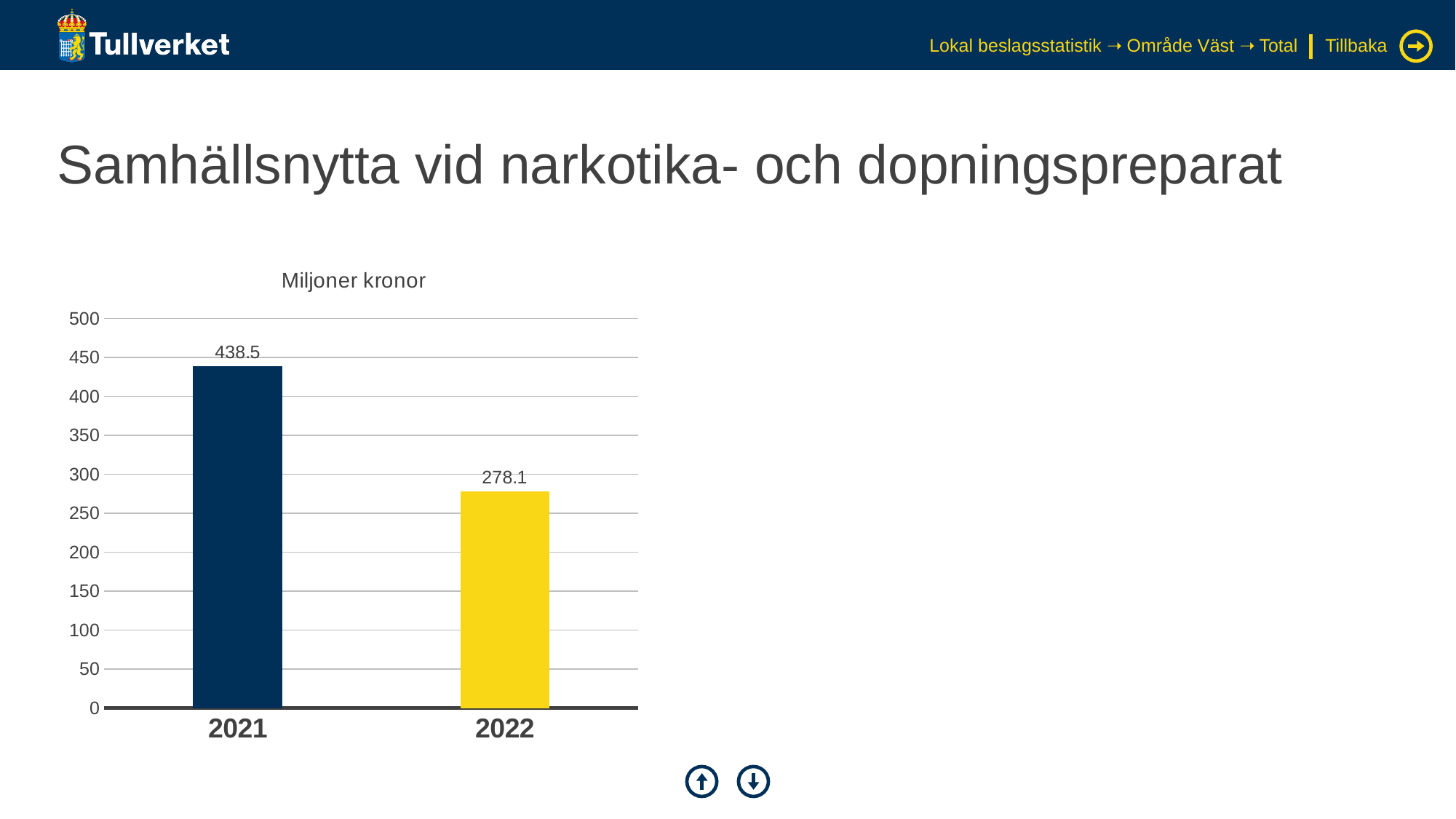
What is the value for 2022? 278.1 What unit is shown above the chart? Miljoner kronor Which year has the lowest value? 2022 How many years are shown on the chart? 2 What kind of chart is shown on the slide? bar chart Which is larger, the value for 2021 or the value for 2022? 2021 What is the value for 2021? 438.5 Do the values rise or fall from 2021 to 2022? fall Which year has the highest value? 2021 What is the difference between the values for 2021 and 2022? 160.4 Is the value for 2022 greater or less than 300? less Is the value for 2021 greater or less than 400? greater